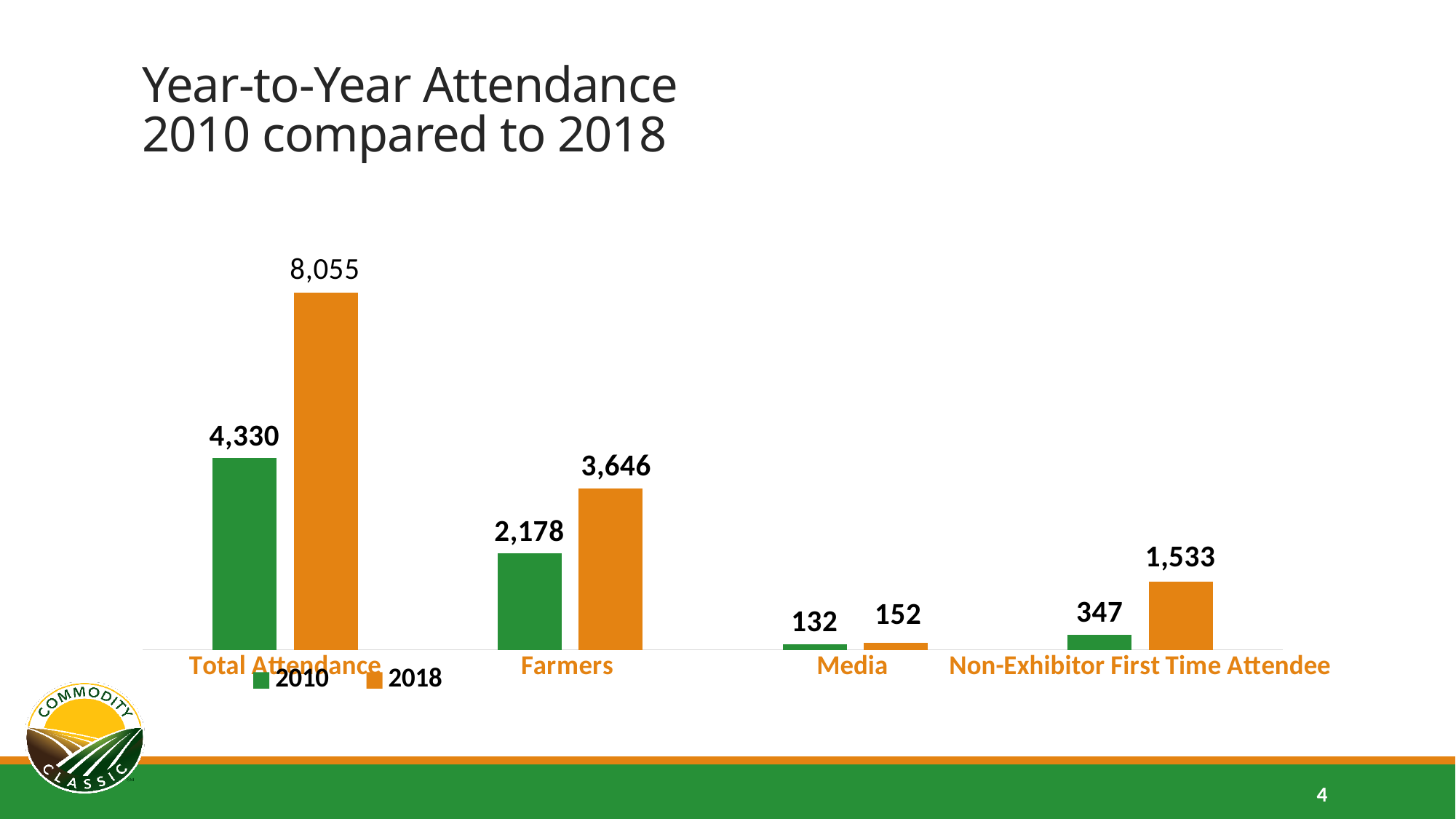
Which category has the lowest 2010 value? Media What is the difference between the 2018 and 2010 values for Non-Exhibitor First Time Attendee? 1,186 What kind of chart is shown on the slide? Bar chart How many series does the legend list? 2 What is the difference between Total Attendance in 2018 and in 2010? 3,725 What was the Media value in 2018? 152 Which category has the highest 2018 value? Total Attendance What was the Non-Exhibitor First Time Attendee value in 2010? 347 What was Total Attendance in 2018? 8,055 How many categories are shown on the x axis? 4 What was the number of Farmers in 2010? 2,178 Which is larger, the 2010 value for Farmers or the 2018 value for Non-Exhibitor First Time Attendee? 2010 value for Farmers